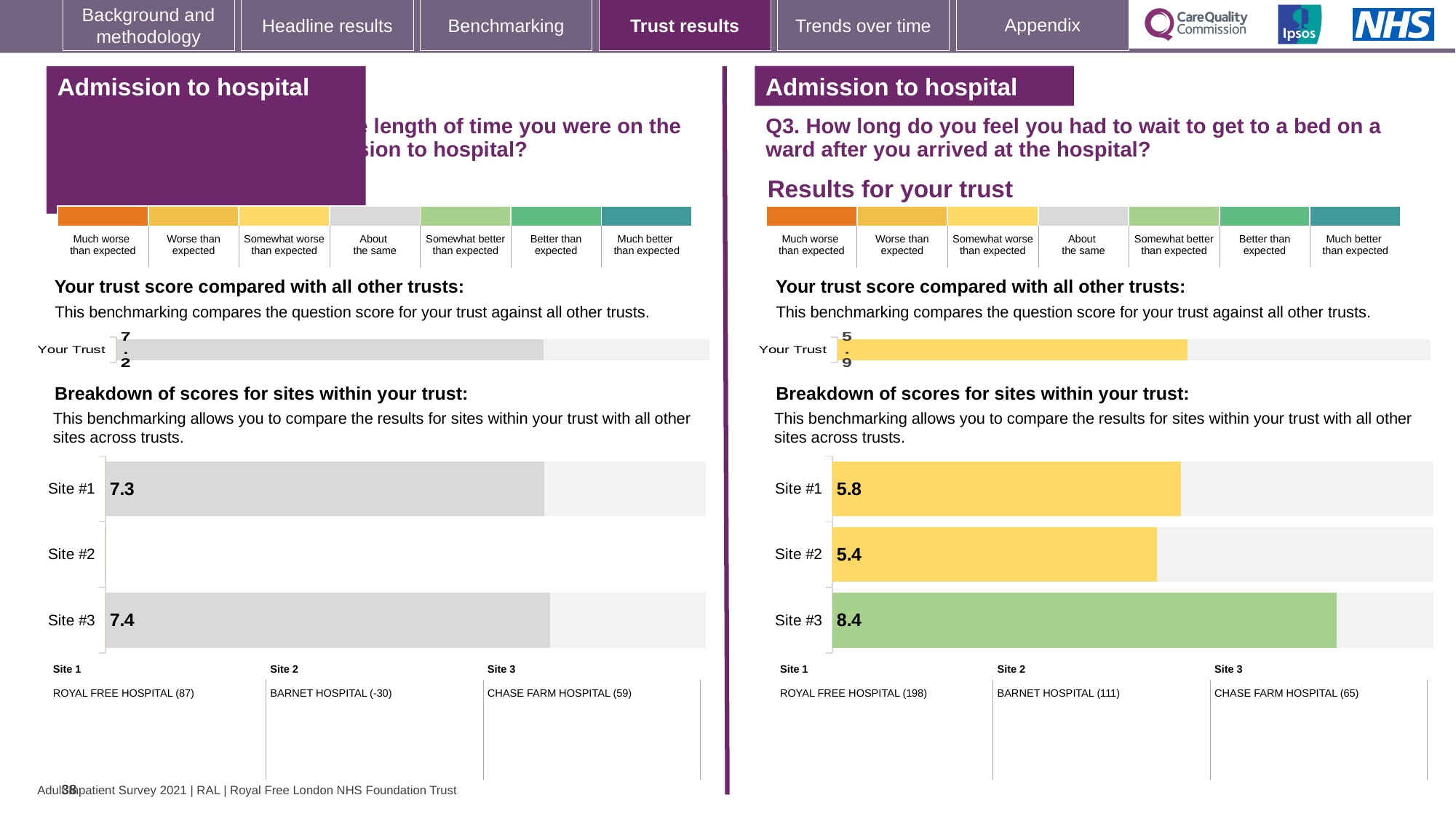
What kind of chart is used for the site breakdown on the right-hand (Q3) side of the slide? Bar chart On the right-hand (Q3) site breakdown chart, is the score for Site #1 larger or smaller than the score for Site #2? Larger On the right-hand (Q3) site breakdown chart, what is the difference between the scores for Site #3 and Site #2? 3.0 On the left-hand site breakdown chart, what is the score for Site #1? 7.3 On the right-hand (Q3) site breakdown chart, what is the score for Site #1? 5.8 On the left-hand site breakdown chart, how many sites are listed? 3 On the left-hand site breakdown chart, what is the score for Site #3? 7.4 On the left-hand 'Your trust score compared with all other trusts' chart, what is the score for Your Trust? 7.2 On the right-hand (Q3) site breakdown chart, which site has the lowest score? Site #2 On the right-hand (Q3) 'Your trust score compared with all other trusts' chart, what is the score for Your Trust? 5.9 On the right-hand (Q3) site breakdown chart, which site has the highest score? Site #3 On the right-hand (Q3) site breakdown chart, what is the score for Site #3? 8.4